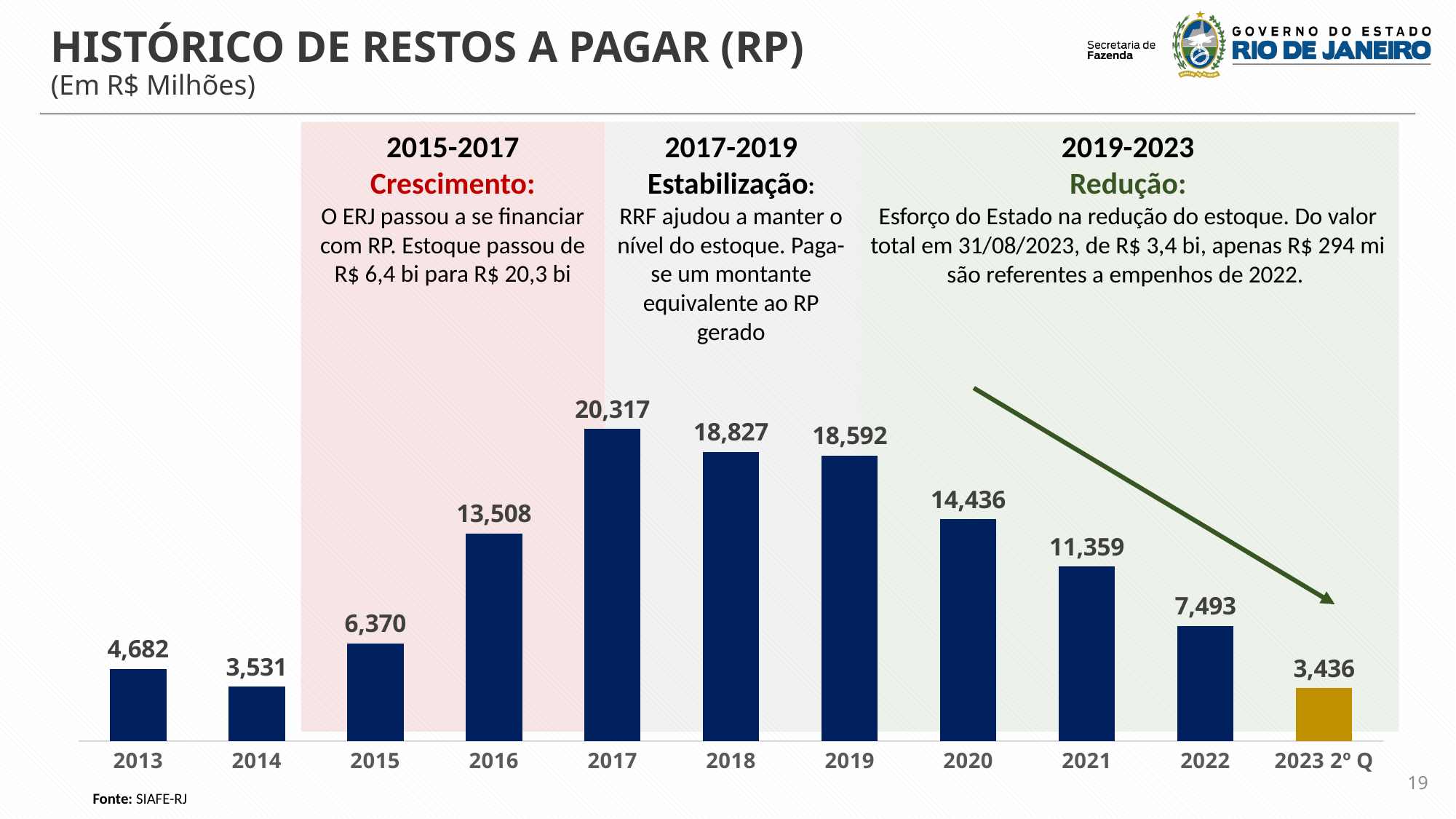
What kind of chart is shown on the slide? Bar chart What is the title of the chart? HISTÓRICO DE RESTOS A PAGAR (RP) What is the value for 2020? 14,436 How many bars are shown in the chart? 11 Do the values rise or fall from 2017 to 2023 2º Q? Fall Which year has the highest value? 2017 Which category has the lowest value? 2023 2º Q What is the value for 2023 2º Q? 3,436 Which is larger, the value for 2013 or the value for 2014? 2013 What is the difference between the values for 2017 and 2018? 1,490 What is the value for 2017? 20,317 What is the difference between the values for 2020 and 2021? 3,077